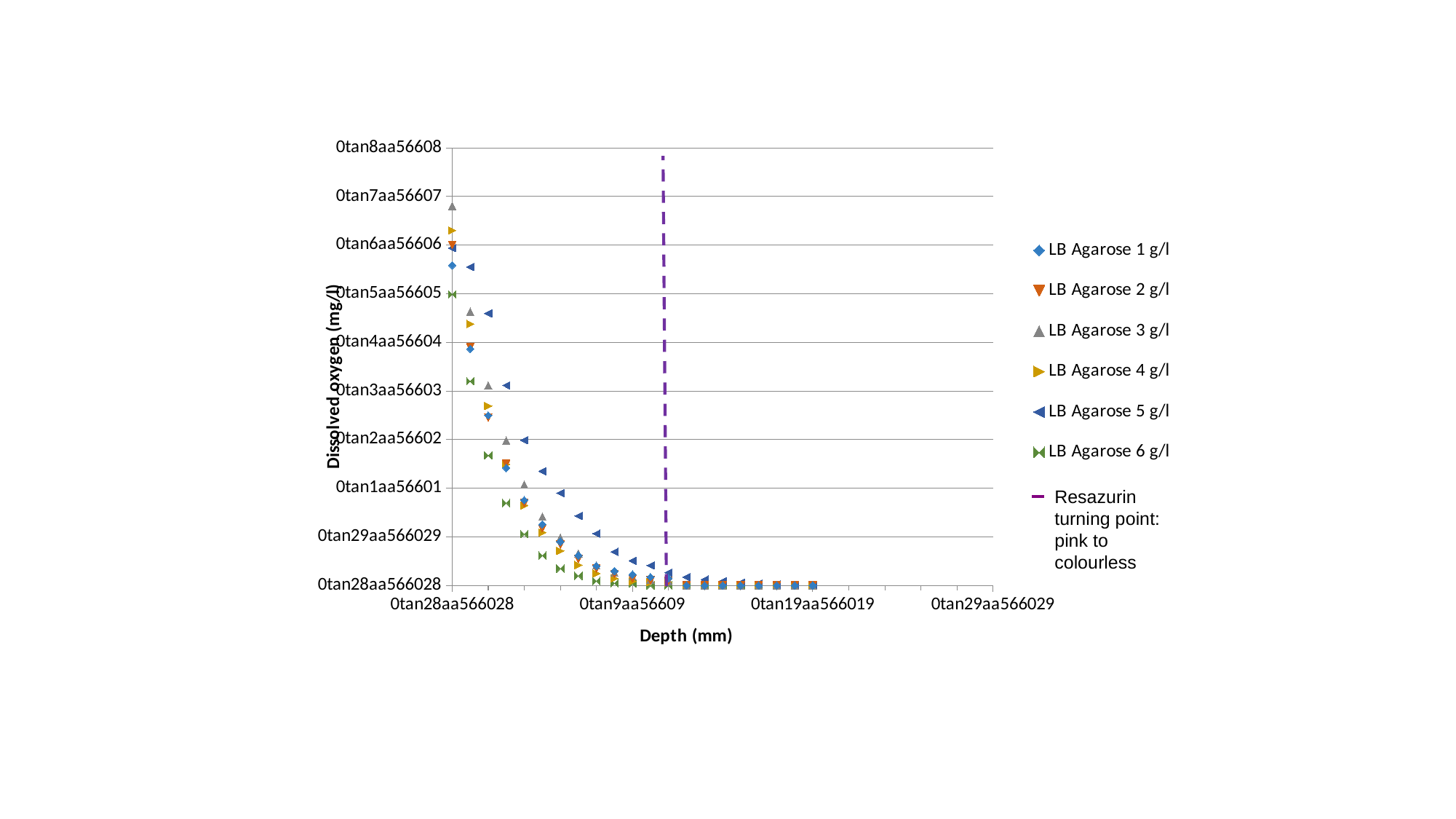
Do the dissolved oxygen values rise or fall as depth increases? Fall In the middle of the depth range, which series stays highest above the others? LB Agarose 5 g/l What is the title of the vertical axis? Dissolved oxygen (mg/l) At the shallowest depth (leftmost points), which series has the highest dissolved oxygen? LB Agarose 3 g/l What does the dashed purple vertical line represent, according to the legend? Resazurin turning point: pink to colourless What kind of chart is shown on the slide? Scatter chart At the shallowest depth, which is higher: LB Agarose 3 g/l or LB Agarose 1 g/l? LB Agarose 3 g/l At the shallowest depth, which is higher: LB Agarose 5 g/l or LB Agarose 6 g/l? LB Agarose 5 g/l At the shallowest depth (leftmost points), which series has the lowest dissolved oxygen? LB Agarose 6 g/l How many LB Agarose concentrations are plotted as data series? 6 How many entries does the legend list? 7